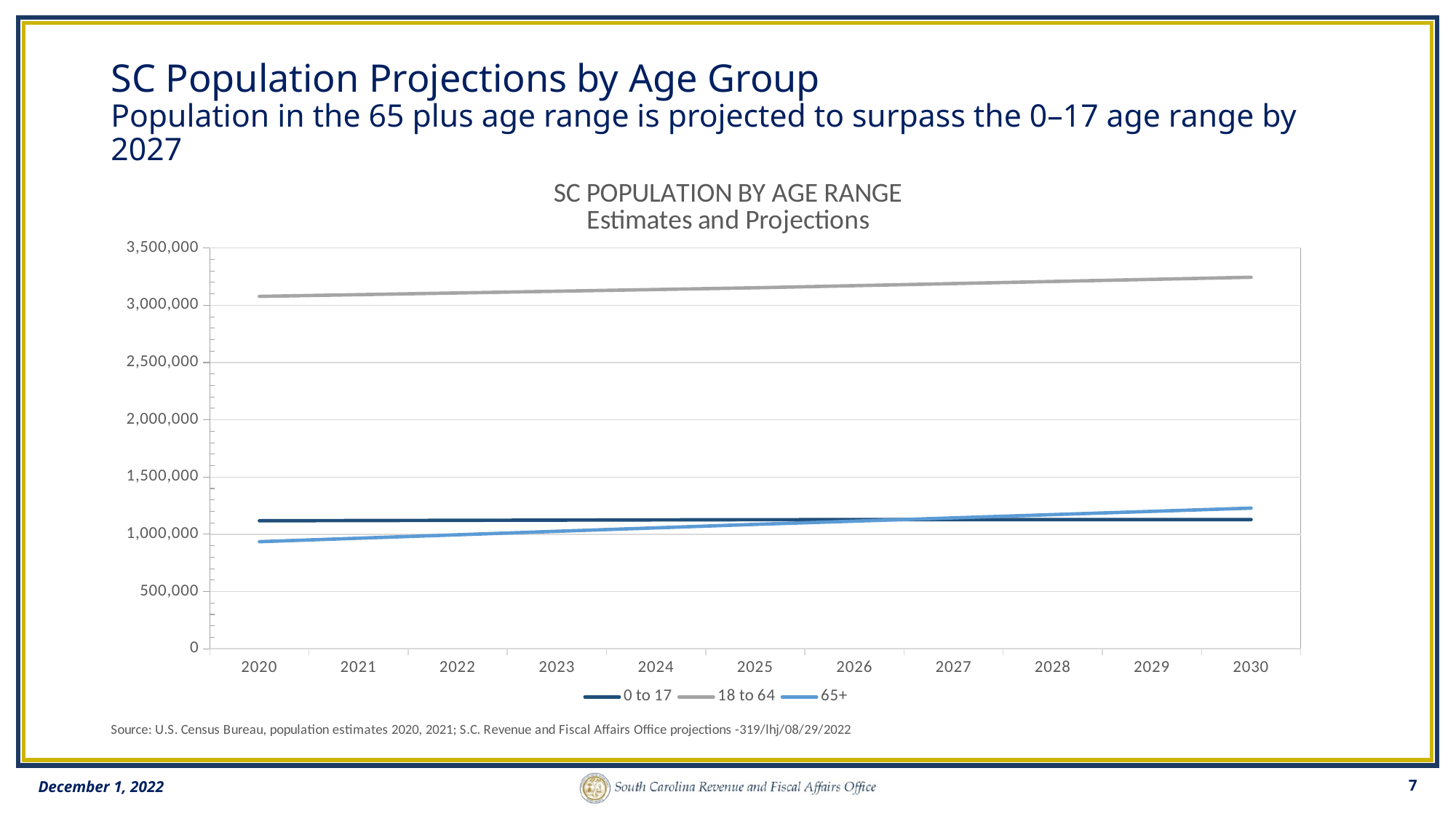
What kind of chart is shown on the slide? line chart Is the value for 65+ in 2030 greater or less than 1,000,000? greater What is the title of the chart? SC POPULATION BY AGE RANGE Estimates and Projections Does the 65+ line rise or fall from 2020 to 2030? rise How many years are shown along the x axis of the chart? 11 Is the value for 65+ in 2020 greater or less than 1,000,000? less How many series does the chart legend list? 3 In 2020, which is larger: the 0 to 17 population or the 65+ population? 0 to 17 Which age range has the lowest population in 2020? 65+ Is the value for 18 to 64 in 2020 greater or less than 3,000,000? greater Which age range has the highest population across all years shown? 18 to 64 In 2030, which is larger: the 65+ population or the 0 to 17 population? 65+